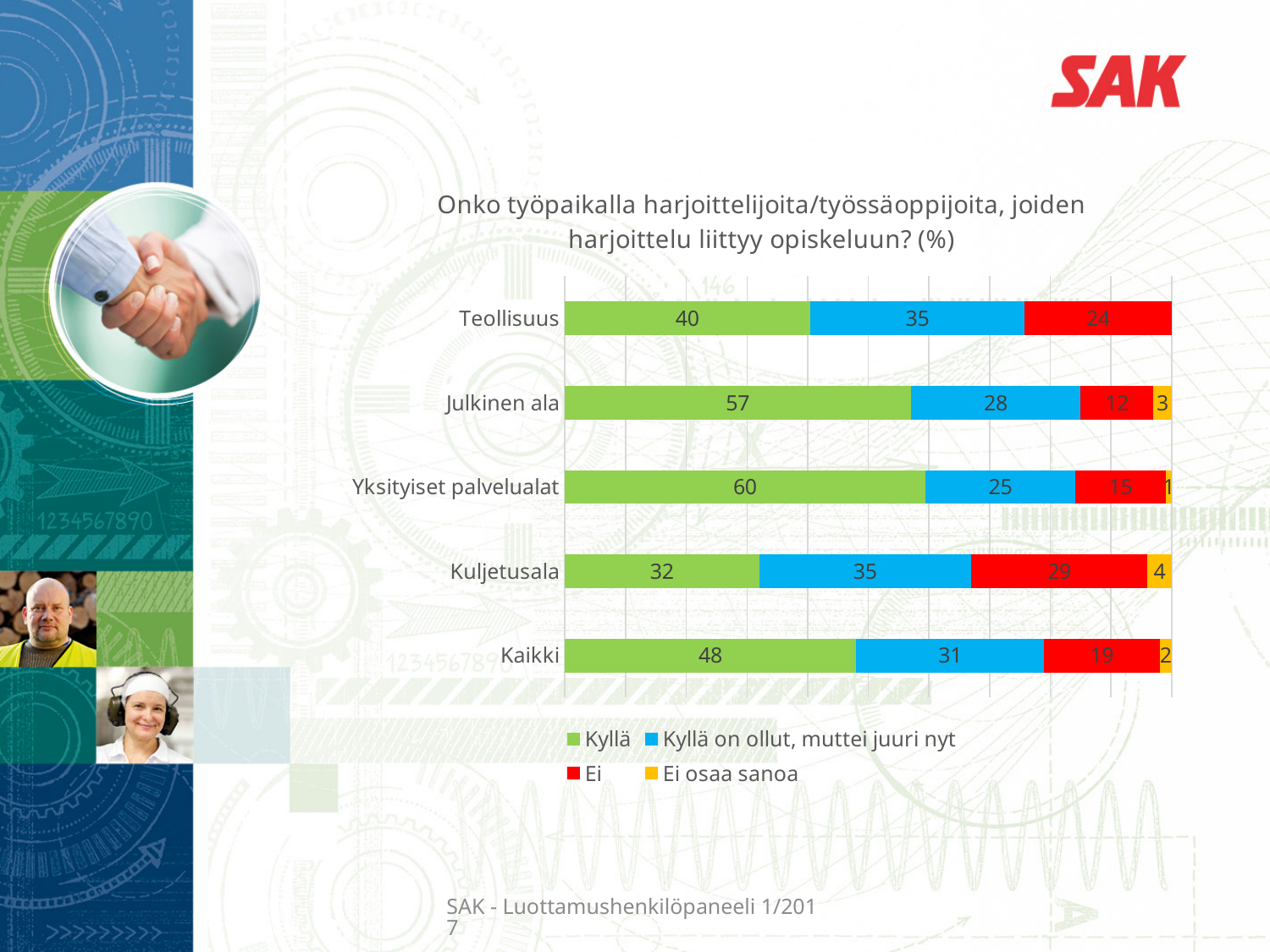
What kind of chart is shown on the slide? Stacked bar chart Which category has the highest 'Kyllä' value? Yksityiset palvelualat What is the 'Kyllä' value for Yksityiset palvelualat? 60 Which series is shown in red in the legend? Ei What is the total of the stacked bar for Kuljetusala? 100 How many series does the legend list? 4 What is the 'Kyllä on ollut, muttei juuri nyt' value for Julkinen ala? 28 Which is larger: the 'Ei' value for Teollisuus or for Kaikki? Teollisuus What is the 'Ei' value for Kuljetusala? 29 What is the difference between the 'Kyllä' values for Julkinen ala and Teollisuus? 17 How many categories (sectors) are shown on the chart? 5 Which category has the lowest 'Kyllä' value? Kuljetusala